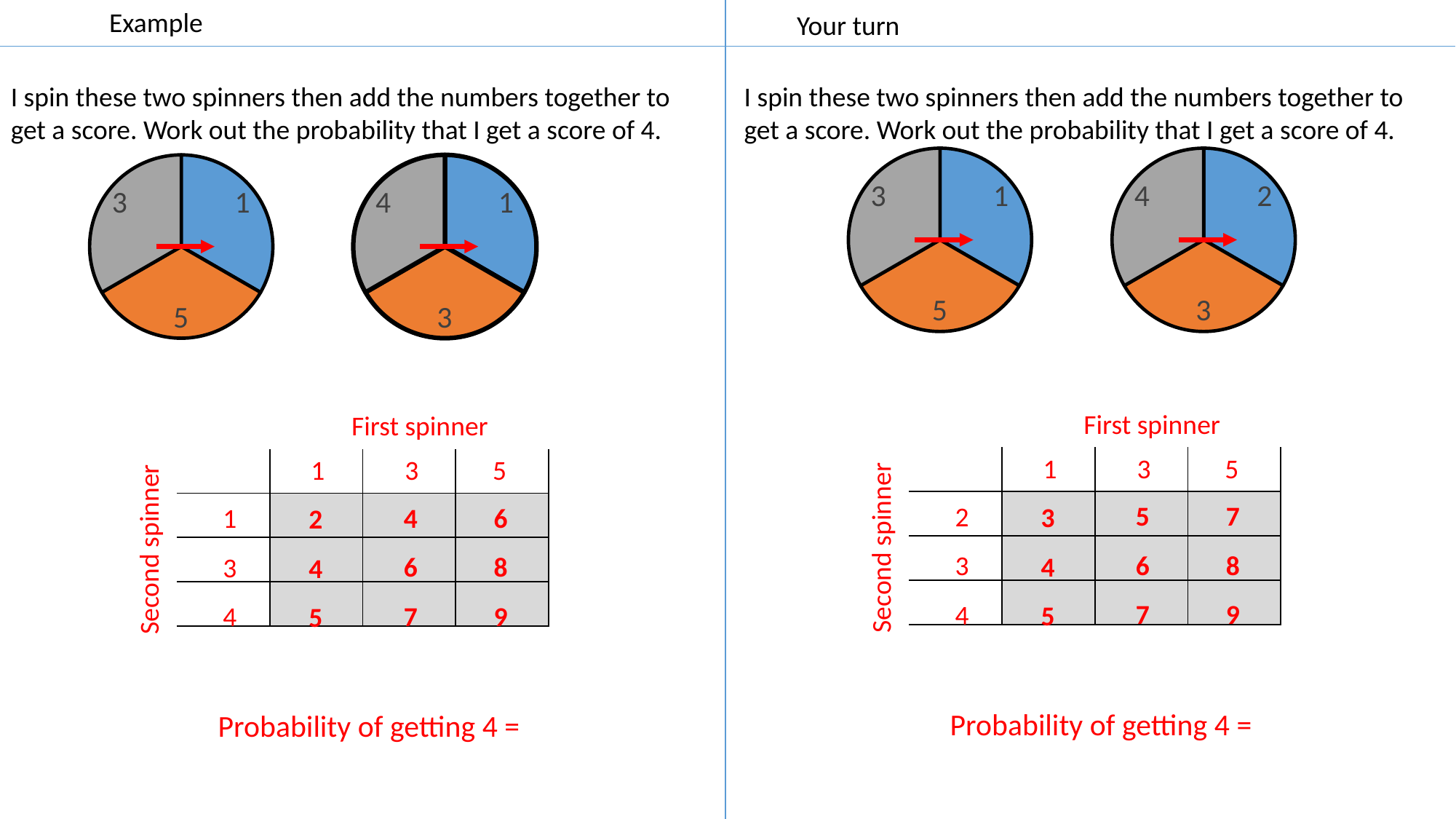
What number is in the blue sector of the second spinner in the Your turn section? 2 How many spinners are shown on the slide in total? 4 Which number on the second spinner in the Your turn section is the smallest? 2 What colour is the sector containing the number 5 on the first spinner in the Your turn section? orange Which is larger: the number in the grey sector of the first Your turn spinner or the number in the grey sector of the second Your turn spinner? the second spinner (4) How many sectors does the first spinner in the Example section have? 3 What number is in the grey sector of the second spinner in the Your turn section? 4 Which number on the first spinner in the Example section is the largest? 5 What number is in the orange sector of the first spinner in the Example section? 5 What is the difference between the largest and smallest numbers on the second spinner in the Example section? 3 What kind of chart is each spinner drawn as? pie chart What number is in the blue sector of the second spinner in the Example section? 1